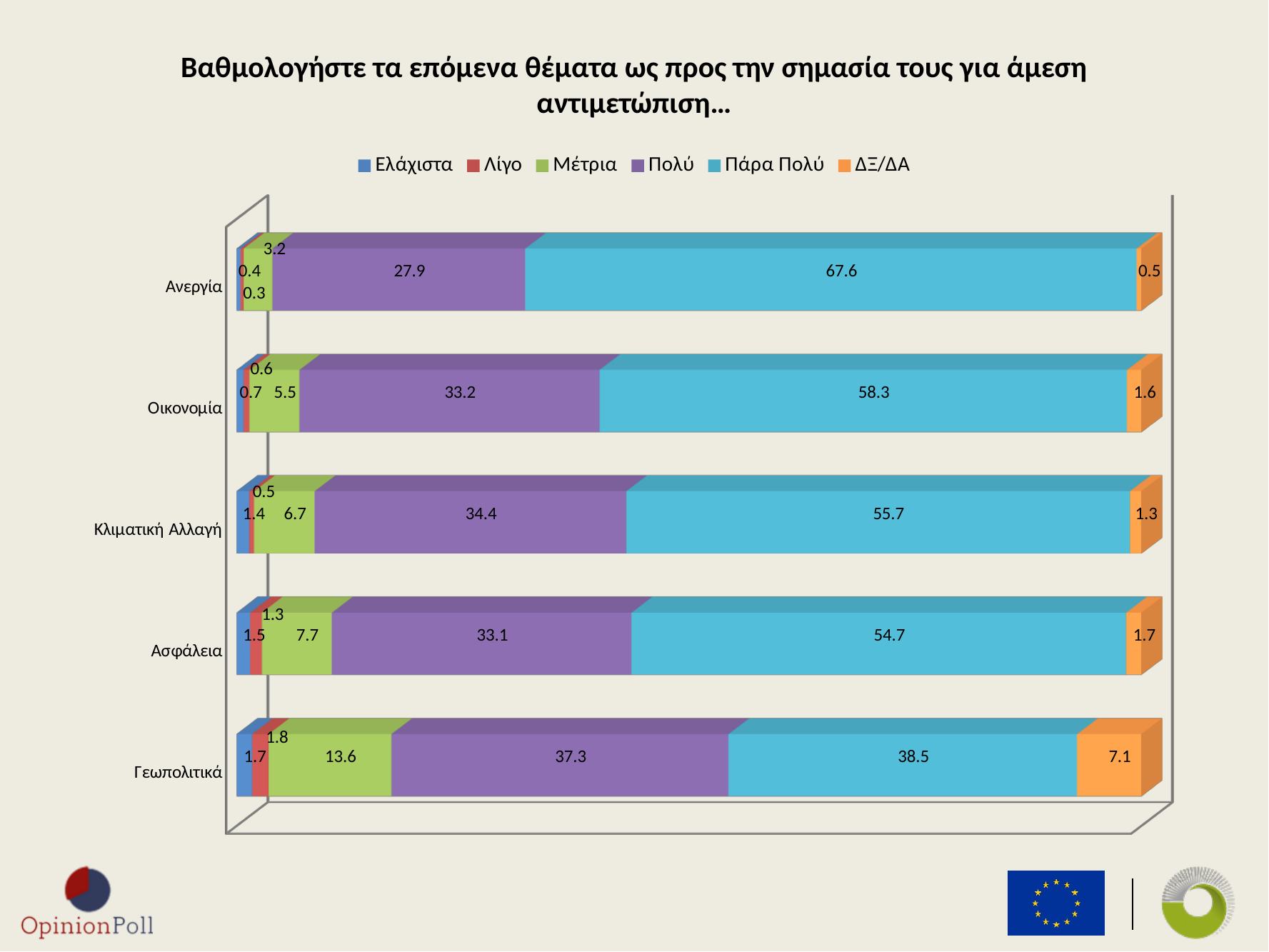
What is the difference between the 'Πάρα Πολύ' values for 'Ανεργία' and 'Οικονομία'? 9.3 How many series does the legend list? 6 What is the value of 'Πάρα Πολύ' for 'Ανεργία'? 67.6 How many categories (topics) are plotted on the chart? 5 What is the value of 'Πολύ' for 'Γεωπολιτικά'? 37.3 Which category has the lowest 'Πάρα Πολύ' value? Γεωπολιτικά Which has the larger 'Πολύ' value, 'Κλιματική Αλλαγή' or 'Ασφάλεια'? Κλιματική Αλλαγή What is the value of 'Μέτρια' for 'Οικονομία'? 5.5 What kind of chart is shown on the slide? Stacked bar chart Which category has the highest 'Πάρα Πολύ' value? Ανεργία What is the value of 'ΔΞ/ΔΑ' for 'Γεωπολιτικά'? 7.1 Which category has the highest 'Μέτρια' value? Γεωπολιτικά